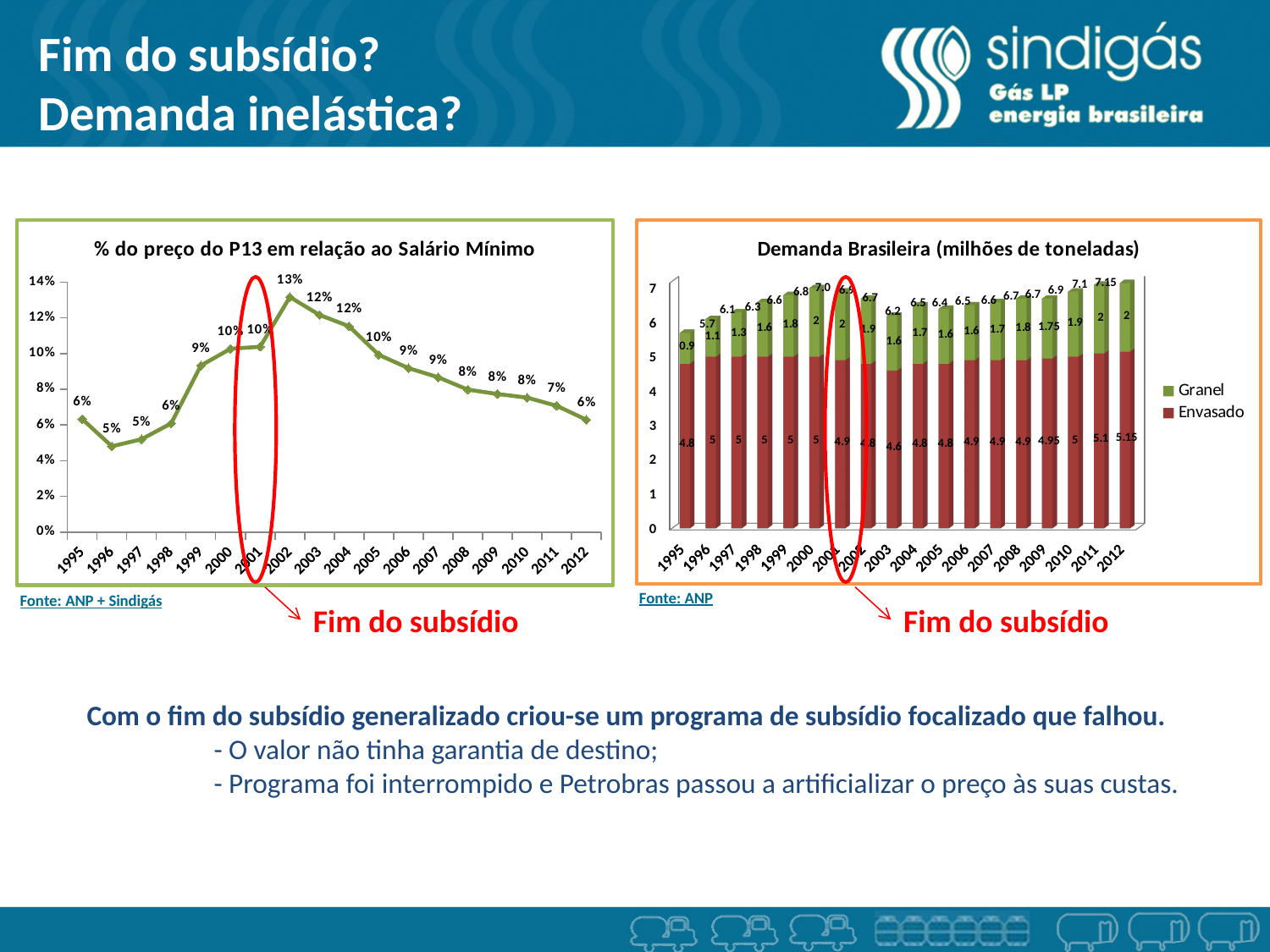
In the right chart 'Demanda Brasileira (milhões de toneladas)', what is the total of the stacked bar for 2012? 7.15 What kind of chart is the right chart, 'Demanda Brasileira (milhões de toneladas)'? Stacked bar chart In the left chart '% do preço do P13 em relação ao Salário Mínimo', what is the difference between the 2002 value and the 2012 value? 7 percentage points In the left chart '% do preço do P13 em relação ao Salário Mínimo', what is the value for 1999? 9% In the left chart '% do preço do P13 em relação ao Salário Mínimo', which year has the highest value? 2002 In the left chart '% do preço do P13 em relação ao Salário Mínimo', do the values rise or fall from 2002 to 2012? Fall What kind of chart is the left chart, '% do preço do P13 em relação ao Salário Mínimo'? Line chart In the right chart 'Demanda Brasileira (milhões de toneladas)', which series is shown in green? Granel In the right chart 'Demanda Brasileira (milhões de toneladas)', what is the Envasado value for 2012? 5.15 How many series does the legend of the right chart 'Demanda Brasileira (milhões de toneladas)' list? 2 In the left chart '% do preço do P13 em relação ao Salário Mínimo', what is the value for 2002? 13% How many years are plotted in the left chart '% do preço do P13 em relação ao Salário Mínimo'? 18